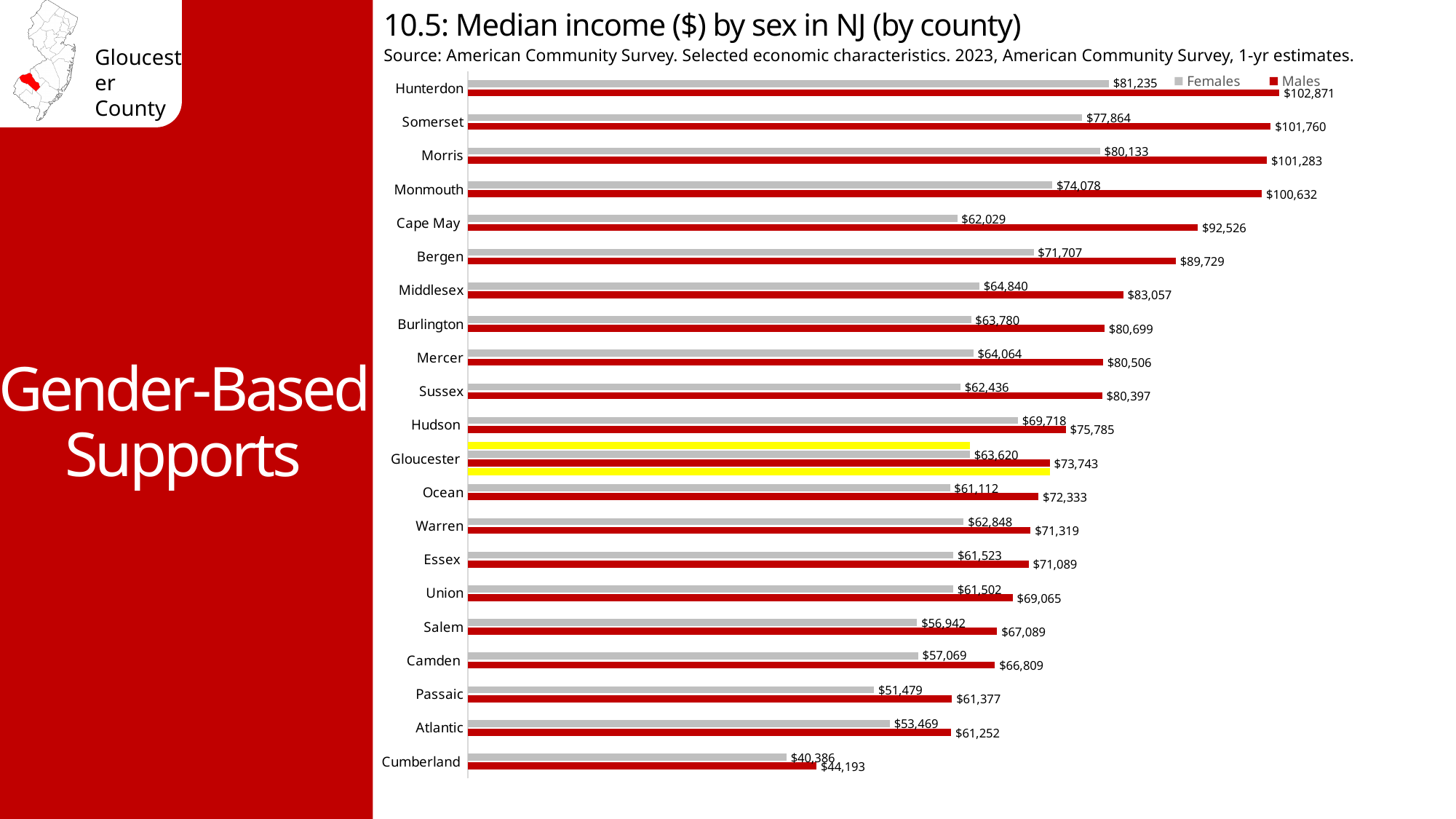
Which colour represents the Males series in the chart? Red What is the difference between male and female median income in Gloucester County? $10,123 Which is larger: the female median income in Bergen County or in Hudson County? Bergen County What is the median income for males in Gloucester County? $73,743 Which county has the highest median income for males? Hunterdon Which county has the lowest median income for females? Cumberland What kind of chart is shown on the slide? Bar chart How many series does the legend list? 2 What is the difference between the male median incomes of Hunterdon and Cumberland counties? $58,678 What is the median income for females in Cumberland County? $40,386 How many counties are shown in the chart? 21 What is the median income for females in Hunterdon County? $81,235